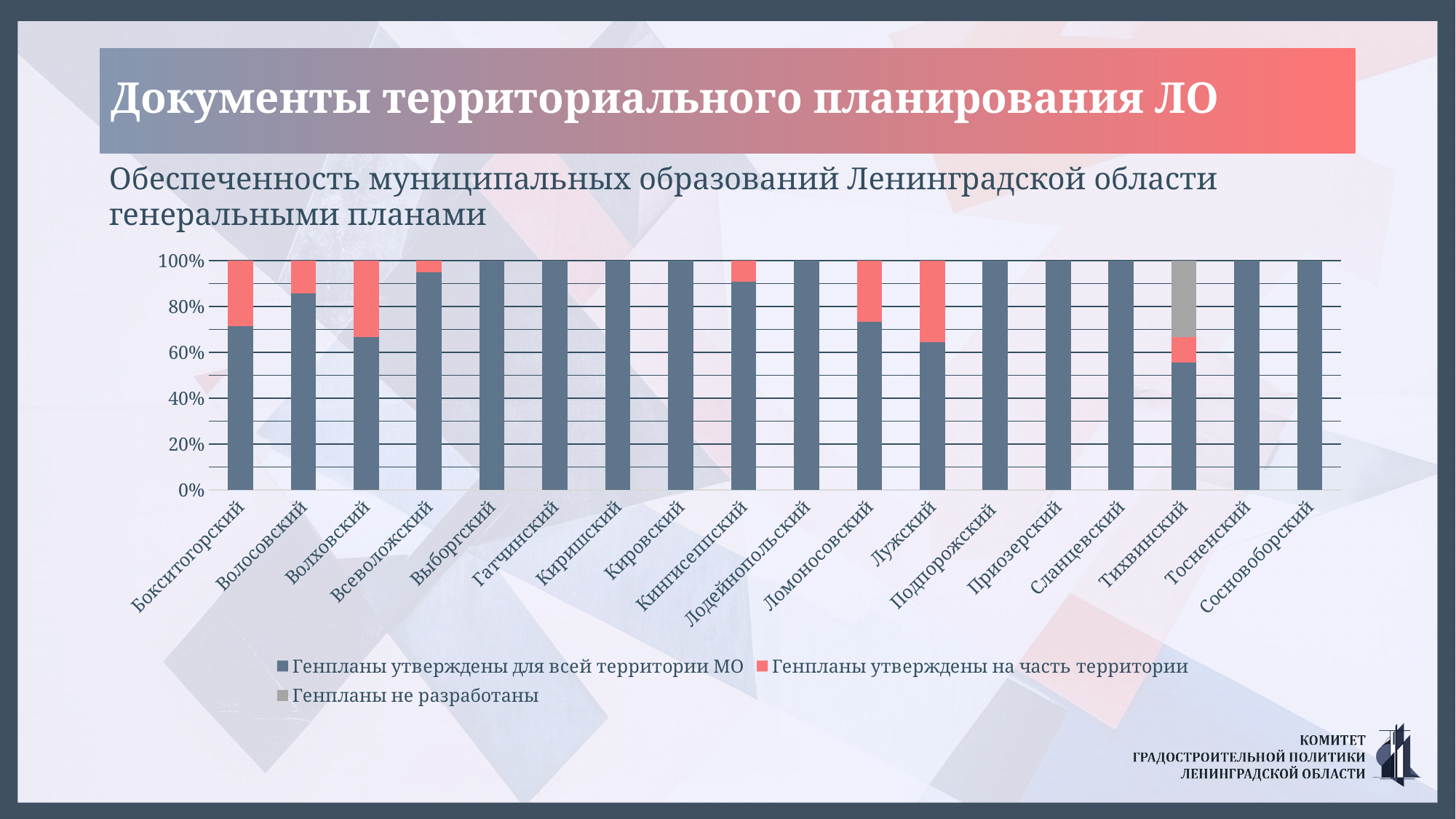
Which district has the lowest share of 'Генпланы утверждены для всей территории МО'? Тихвинский How many series does the chart legend list? 3 Is the share of 'Генпланы утверждены для всей территории МО' for Волосовский greater or less than 80%? greater Is the share of 'Генпланы утверждены для всей территории МО' for Лужский greater or less than 60%? greater How many municipal districts (categories) are shown on the x axis of the chart? 18 What kind of chart is shown on the slide? Stacked bar chart What is the subtitle of the chart shown on the slide? Обеспеченность муниципальных образований Ленинградской области генеральными планами Is the share of 'Генпланы утверждены для всей территории МО' for Бокситогорский greater or less than 80%? less Which district is the only one with a grey segment (Генпланы не разработаны) in its bar? Тихвинский What is the total height of each stacked bar in the chart? 100% Which has a larger share of 'Генпланы утверждены для всей территории МО': Волосовский or Волховский? Волосовский